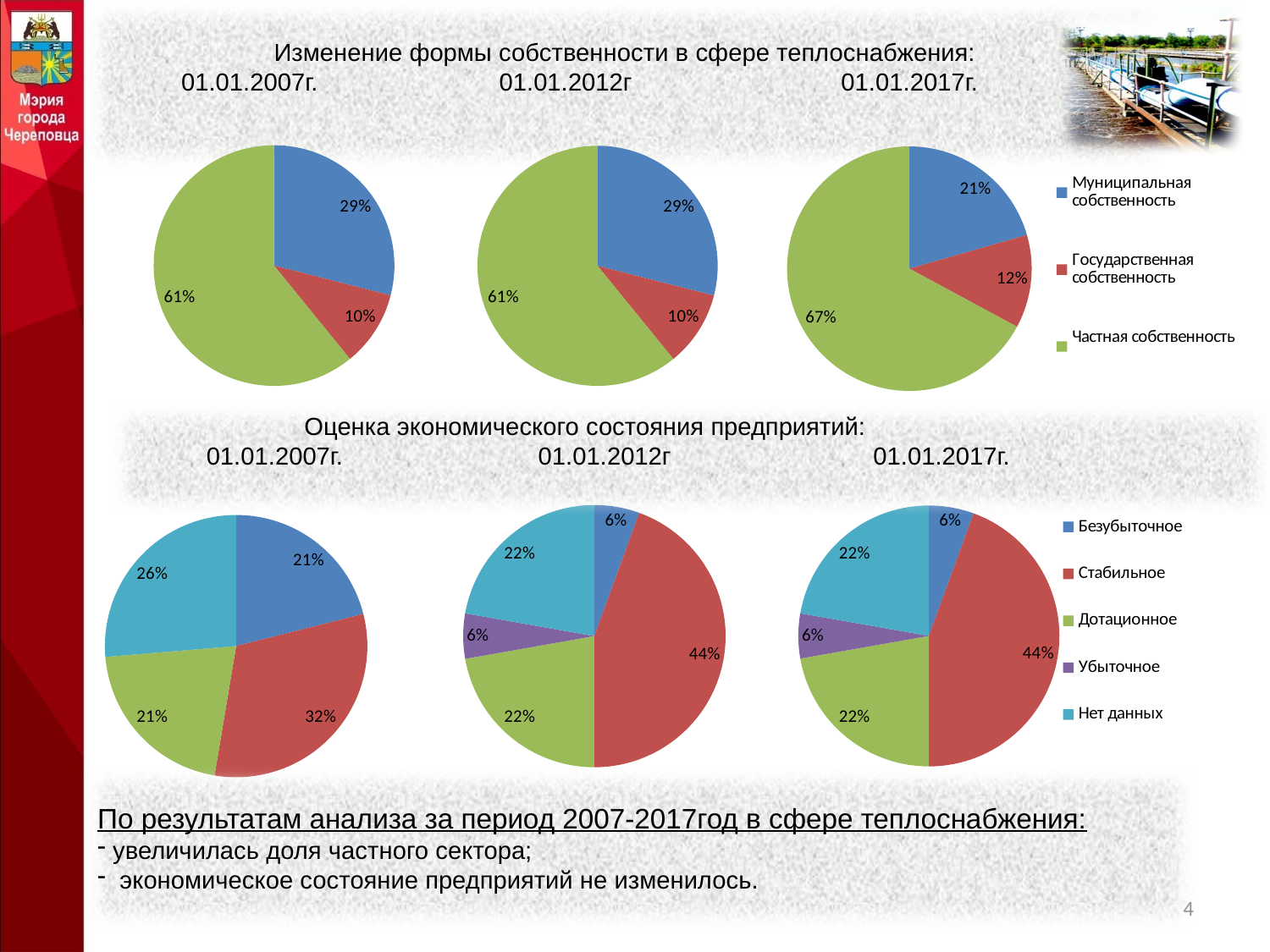
In the top-row chart for 01.01.2012г, which ownership form has the largest share? Частная собственность In the bottom-row chart 'Оценка экономического состояния предприятий' for 01.01.2007г., what share is Стабильное? 32% By how many percentage points does the share of Частная собственность in the top-row 01.01.2017г. chart exceed that in the 01.01.2007г. chart? 6 What type of chart is used for the 01.01.2012г ownership chart in the top row? Pie chart In the top-row chart for 01.01.2007г., which ownership form has the smallest share? Государственная собственность In the bottom-row chart for 01.01.2007г., which is larger: Нет данных or Безубыточное? Нет данных How many categories does the legend of the bottom-row charts list? 5 In the bottom-row chart for 01.01.2017г., which category has the largest share? Стабильное In the bottom-row chart for 01.01.2012г, what share is Убыточное? 6% In the top-row chart 'Изменение формы собственности в сфере теплоснабжения' for 01.01.2017г., what share is Частная собственность? 67% In the top-row chart for 01.01.2017г., what share is Государственная собственность? 12% In the top-row chart for 01.01.2007г., what share is Муниципальная собственность? 29%